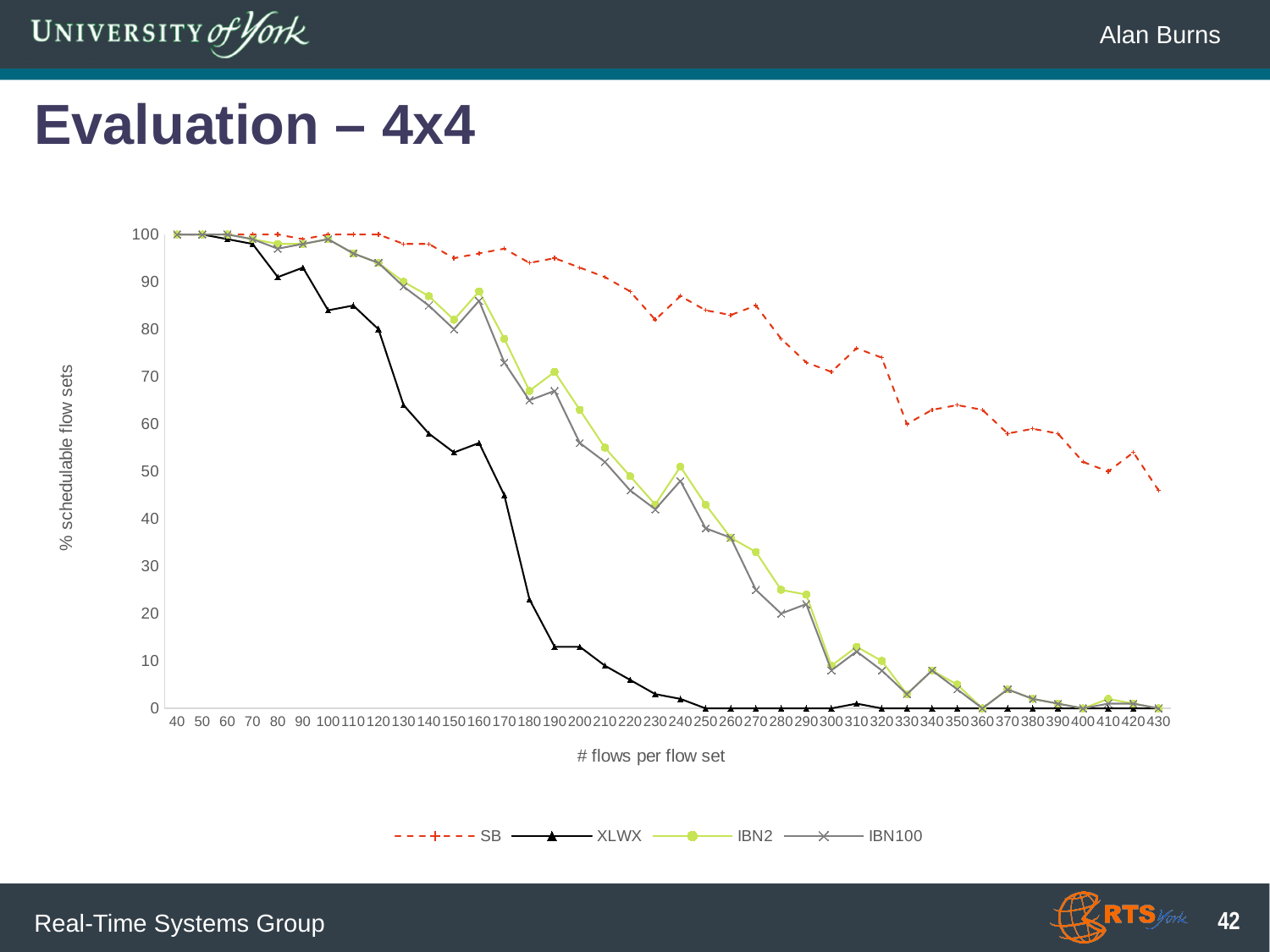
Do the values for XLWX rise or fall as # flows per flow set increases? fall Which series has the highest value at 430 flows per flow set? SB How many series does the legend list? 4 At 300 flows per flow set, which is larger, IBN2 or XLWX? IBN2 What is the label of the y axis? % schedulable flow sets Is the value for XLWX at 180 flows per flow set greater or less than 30? less Is the value for IBN2 at 200 flows per flow set greater or less than 60? greater Is the value for SB at 430 flows per flow set greater or less than 50? less What kind of chart is shown on the slide? line chart Which series has the lowest value at 200 flows per flow set? XLWX How many points along the x axis (# flows per flow set) are plotted for each series? 40